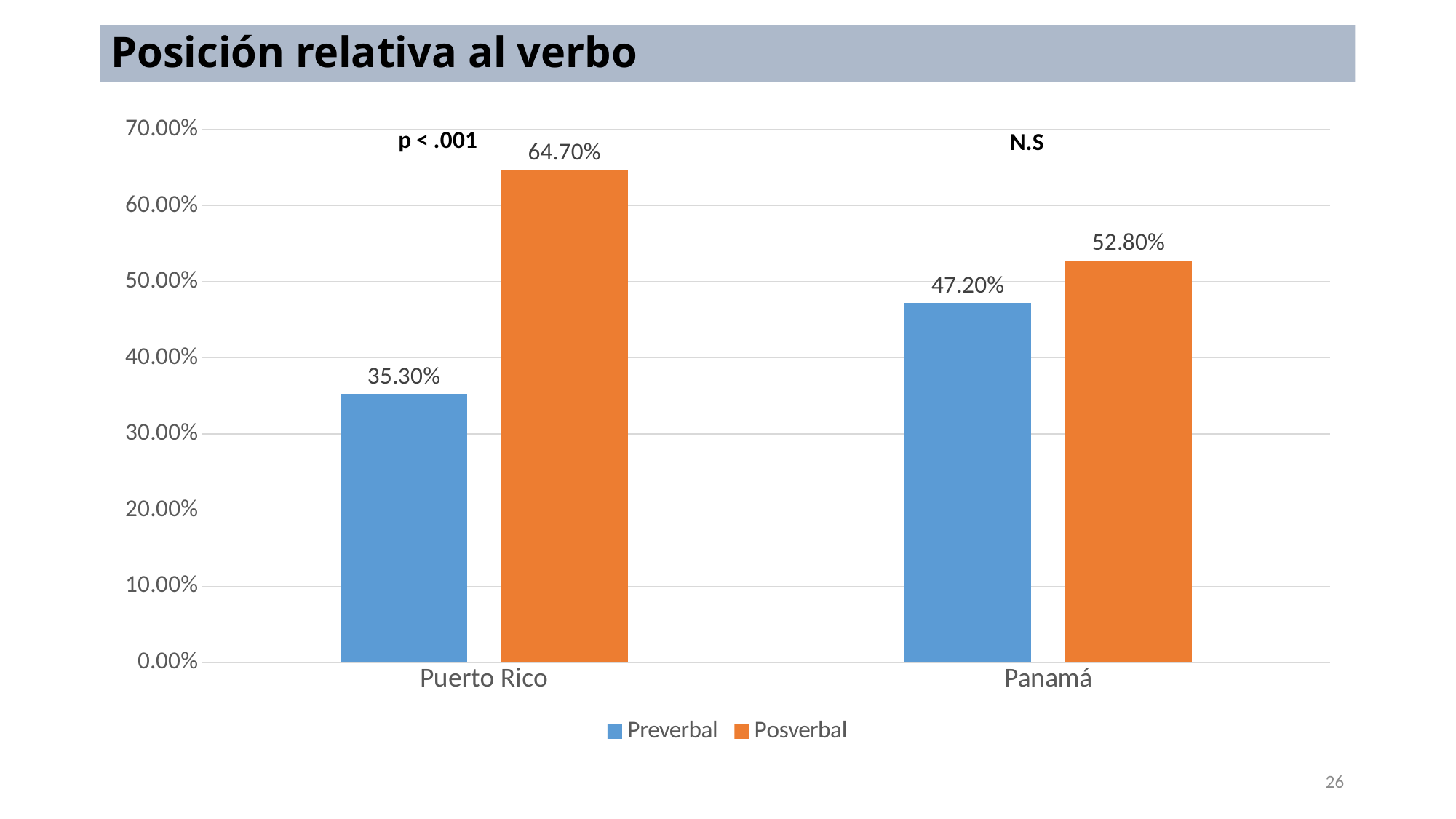
What is the difference between the Posverbal and Preverbal values for Puerto Rico? 29.40% What is the Preverbal value for Panamá? 47.20% What is the Preverbal value for Puerto Rico? 35.30% Which bar has the lowest value on the chart? Preverbal for Puerto Rico Which is larger for Panamá, Preverbal or Posverbal? Posverbal What is the difference between the Posverbal and Preverbal values for Panamá? 5.60% How many series does the legend list? 2 How many categories are shown on the x axis? 2 What is the Posverbal value for Puerto Rico? 64.70% What kind of chart is shown on the slide? Bar chart What is the Posverbal value for Panamá? 52.80% Which bar has the highest value on the chart? Posverbal for Puerto Rico